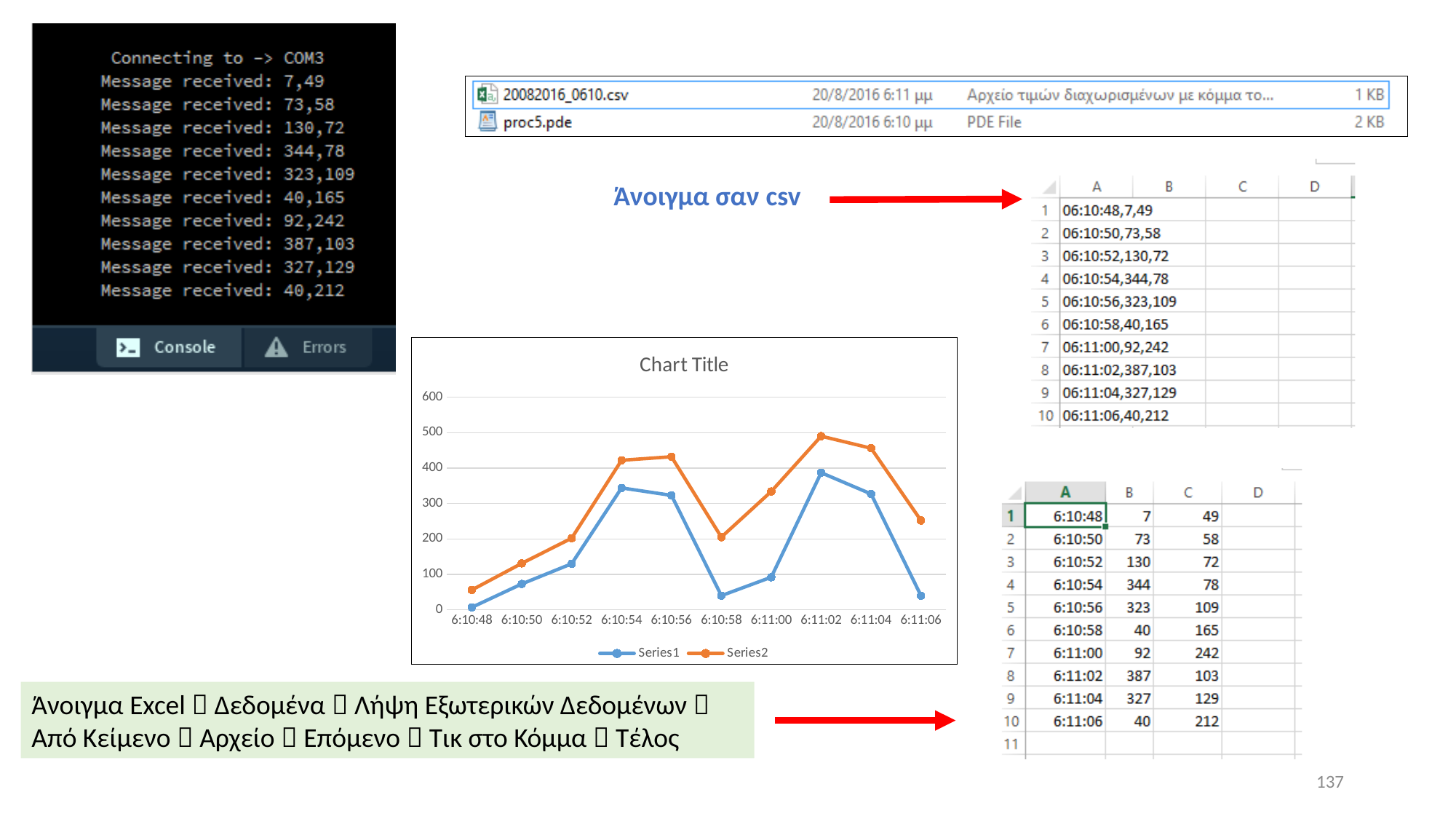
At which time does Series1 reach its highest value? 6:11:02 What kind of chart is shown on the slide? line chart Is the value for Series1 at 6:10:58 greater or less than 100? less Is the value for Series1 at 6:10:54 greater or less than 300? greater How many series does the chart legend list? 2 At which time does Series2 reach its highest value? 6:11:02 Does Series1 rise or fall from 6:10:48 to 6:10:54? rise What is the title of the chart? Chart Title At which time does Series2 reach its lowest value? 6:10:48 Which colour is used for Series1 in the chart? blue How many time points are plotted along the x axis of the chart? 10 Is the value for Series2 at 6:11:02 greater or less than 400? greater